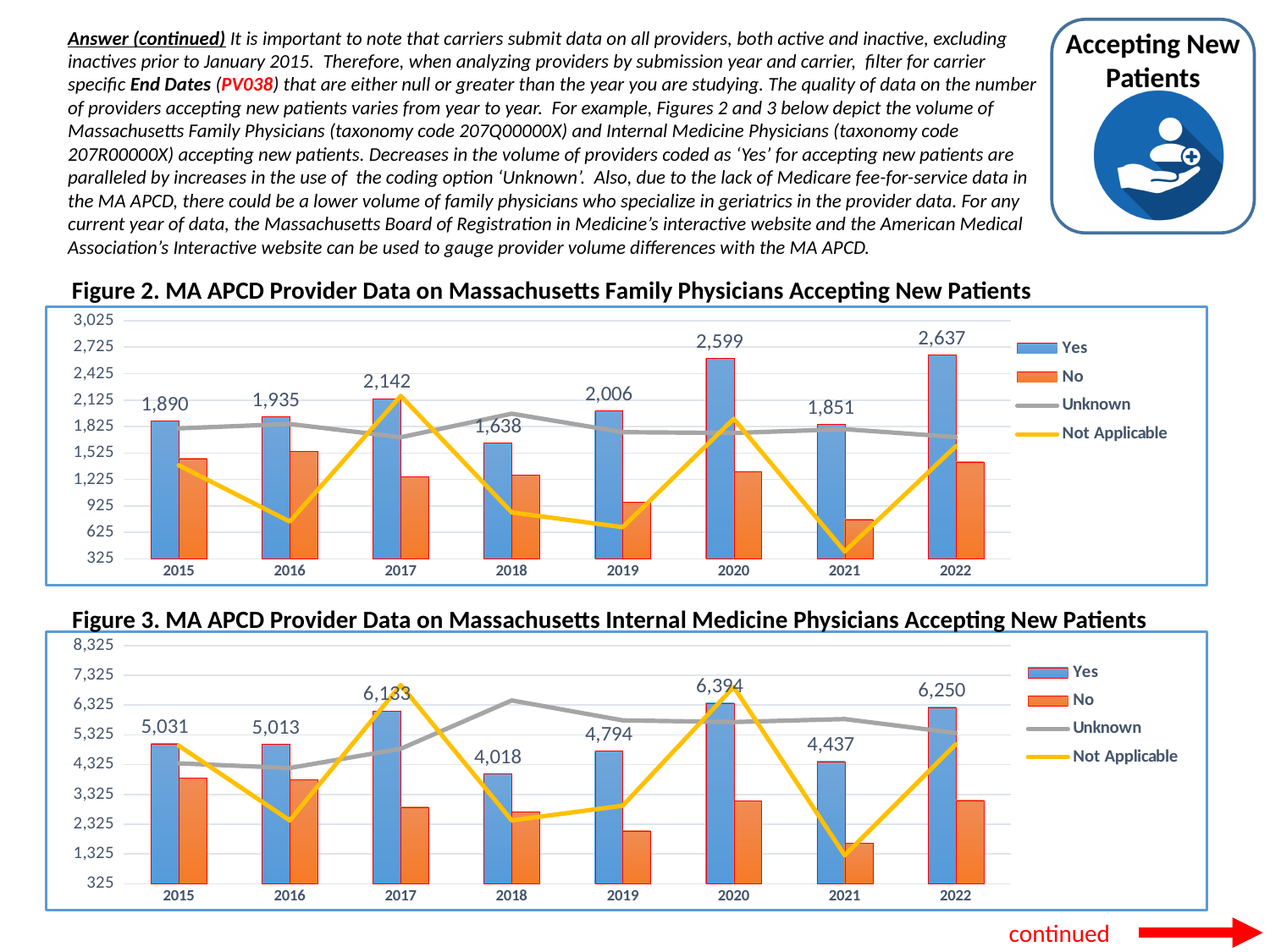
In Figure 2 (Family Physicians), which year has the lowest 'Yes' value? 2018 In Figure 2 (Family Physicians), what is the difference between the 'Yes' values for 2022 and 2021? 786 How many years are shown on the x axis of Figure 3? 8 In Figure 3 (Internal Medicine Physicians), which year has the highest 'Yes' value? 2020 In Figure 3 (Internal Medicine Physicians), what is the 'Yes' value for 2019? 4,794 In Figure 3, what colour is the 'Not Applicable' line? Yellow In Figure 3 (Internal Medicine Physicians), which is larger, the 'Yes' value for 2015 or for 2016? 2015 In Figure 2 (Family Physicians), is the 'No' value for 2021 greater or less than 925? less In Figure 2 (Family Physicians), what is the 'Yes' value for 2020? 2,599 In Figure 2 (Family Physicians), which year has the highest 'Yes' value? 2022 In Figure 3 (Internal Medicine Physicians), what is the difference between the 'Yes' values for 2020 and 2018? 2,376 How many series does the legend of Figure 2 list? 4